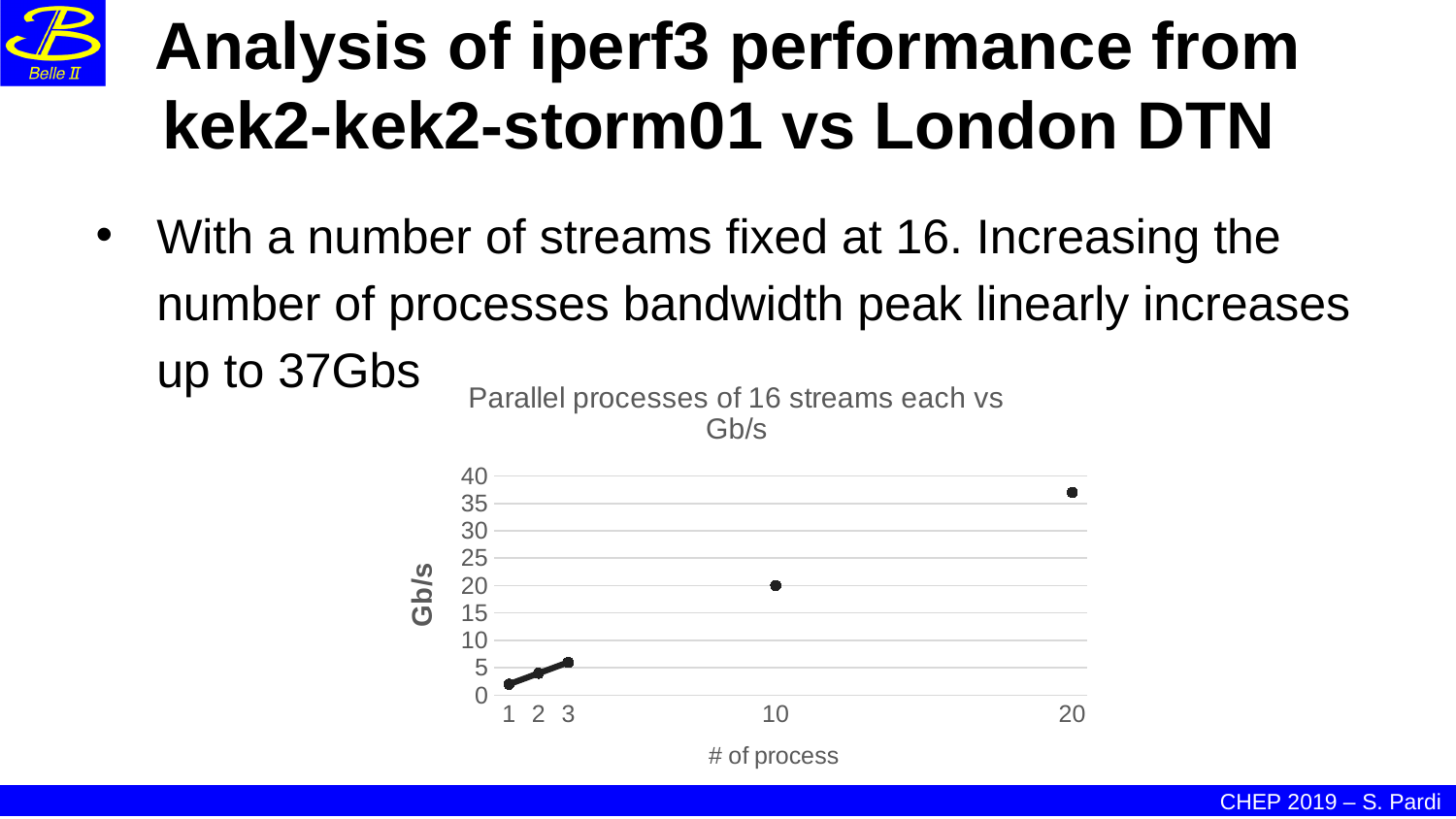
Is the Gb/s value for 3 processes greater or less than 10? less Is the Gb/s value for 20 processes greater or less than 35? greater Which number of processes has the lowest Gb/s value? 1 Which number of processes has the highest Gb/s value? 20 Which has a higher Gb/s value, 10 processes or 20 processes? 20 processes How many data points are plotted in the chart? 5 What kind of chart is shown on the slide? line chart Do the Gb/s values rise or fall as the number of processes increases? rise Is the Gb/s value for 1 process greater or less than 5? less What is the title of the chart? Parallel processes of 16 streams each vs Gb/s What is the label of the x axis of the chart? # of process What is the Gb/s value for 10 processes? 20